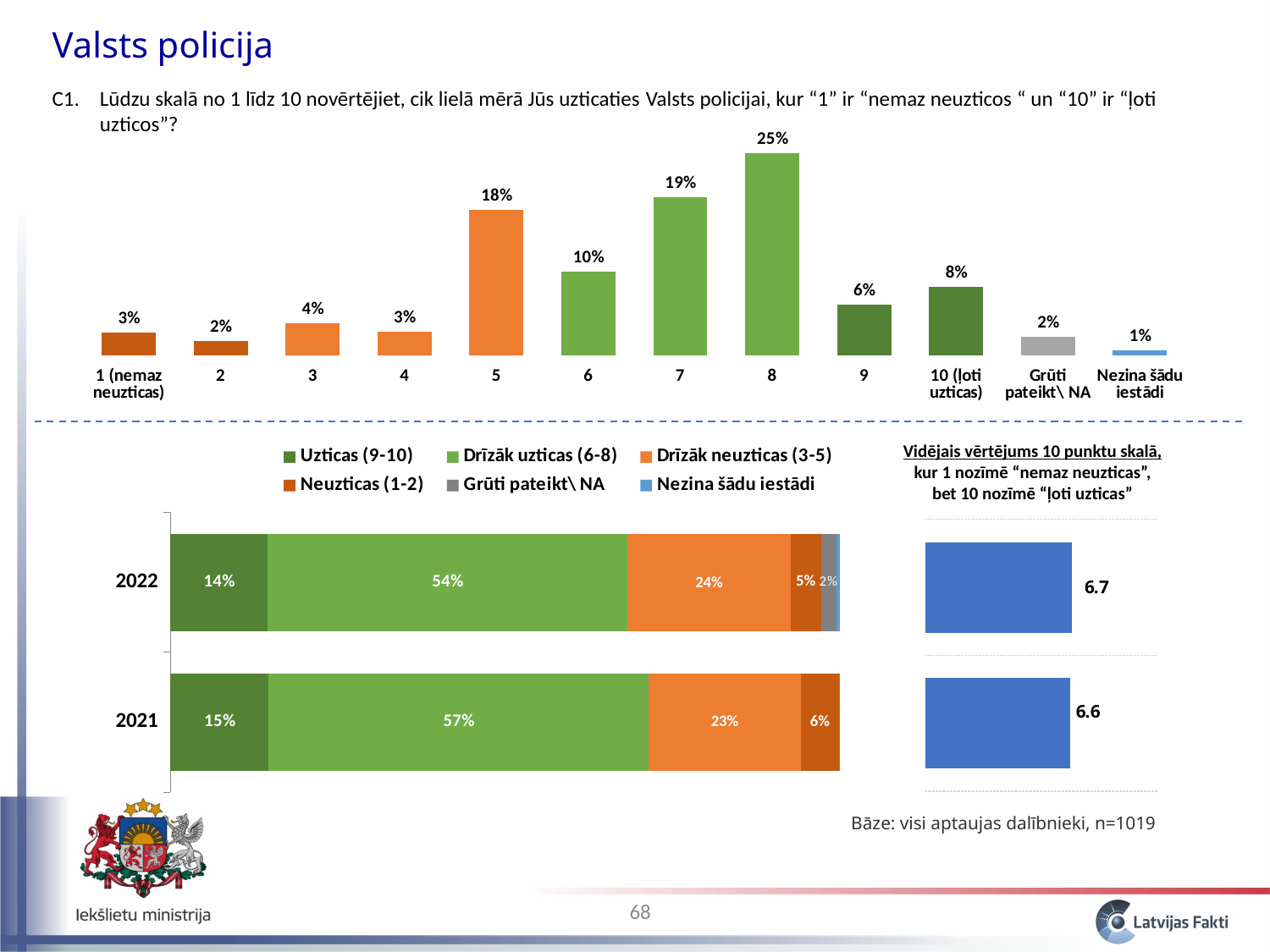
In the top bar chart, which rating category has the highest value? 8 In the bottom-right chart showing the average rating on a 10-point scale, what is the value for 2022? 6.7 In the top bar chart, what percentage of respondents gave a rating of 8? 25% In the top bar chart, which category has the lowest value? Nezina šādu iestādi How many series does the legend of the bottom-left stacked bar chart list? 6 In the top bar chart, which is larger: the value for rating 7 or the value for rating 9? 7 How many categories are shown on the x axis of the top bar chart? 12 In the bottom-left stacked bar chart, what is the value of "Drīzāk neuzticas (3-5)" for 2021? 23% In the bottom-left stacked bar chart, what is the value of "Drīzāk uzticas (6-8)" for 2022? 54% In the top bar chart, what is the difference between the values for rating 5 and rating 6? 8% In the top bar chart, what percentage of respondents answered "10 (ļoti uzticas)"? 8% In the bottom-right chart showing the average rating, which year has the higher value, 2022 or 2021? 2022